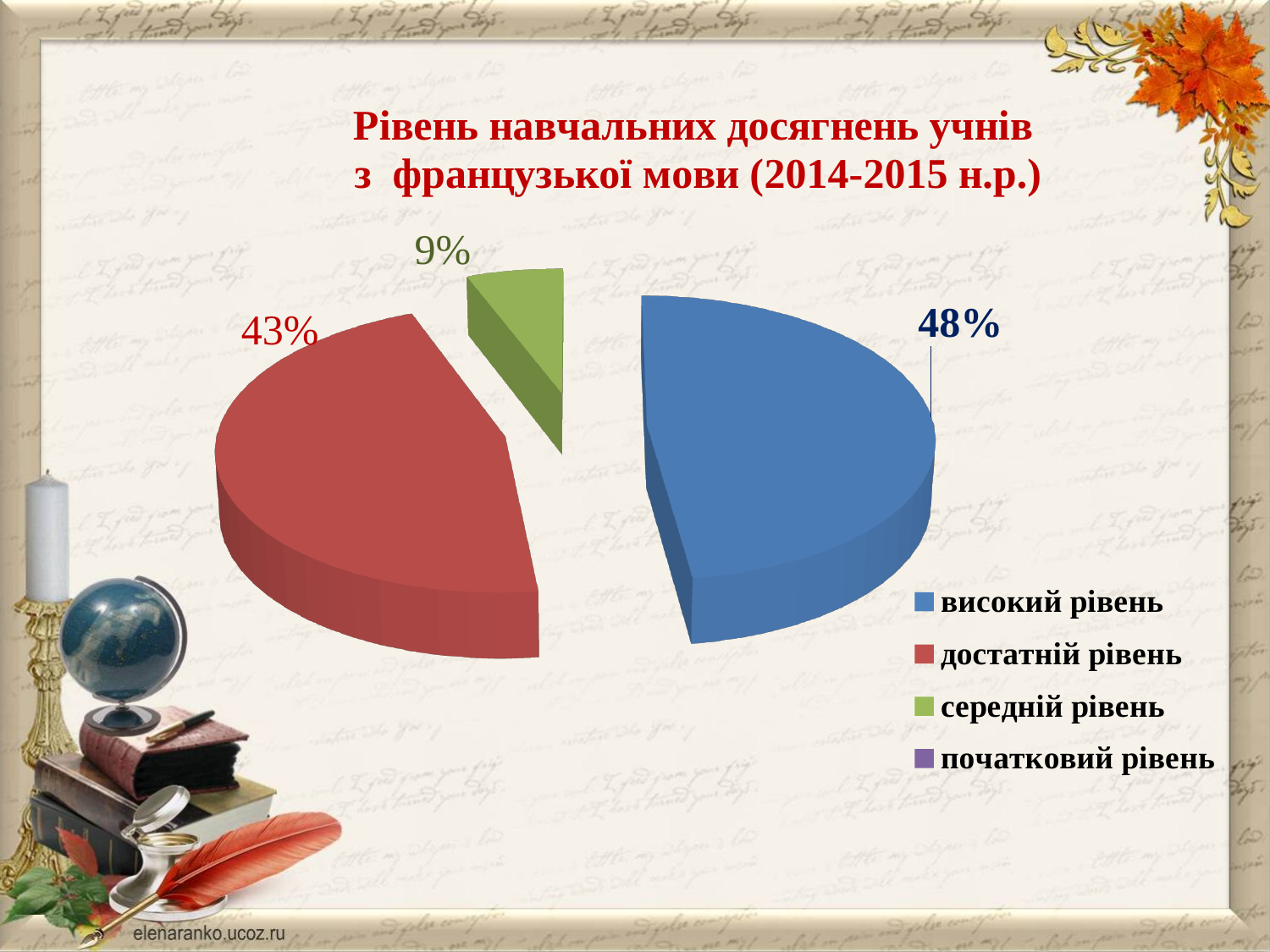
Which is larger, the share for високий рівень or the share for достатній рівень? високий рівень How many entries does the legend list? 4 What is the title of the chart? Рівень навчальних досягнень учнів з французької мови (2014-2015 н.р.) What is the difference between the shares for достатній рівень and середній рівень? 34% What kind of chart is shown on the slide? pie chart What is the difference between the shares for високий рівень and достатній рівень? 5% Which level has the largest slice of the pie? високий рівень What colour is the slice for достатній рівень? red What is the share for високий рівень? 48% Which of the visible slices is the smallest? середній рівень What is the share for достатній рівень? 43% What is the share for середній рівень? 9%